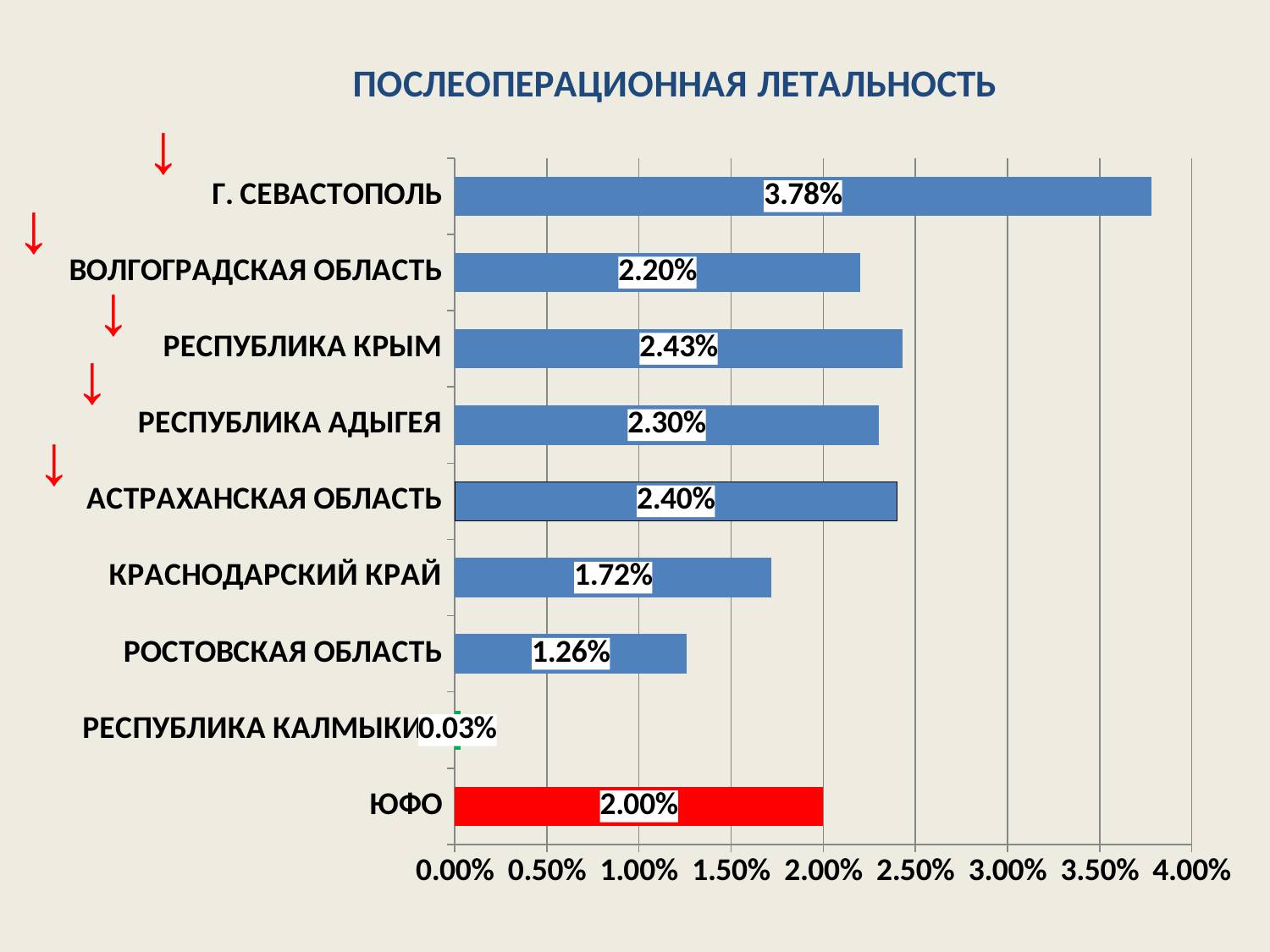
Is the value for КРАСНОДАРСКИЙ КРАЙ greater or less than 2.00%? less What is the value for Г. СЕВАСТОПОЛЬ? 3.78% Which category has the lowest value? РЕСПУБЛИКА КАЛМЫКИЯ What is the title of the chart? ПОСЛЕОПЕРАЦИОННАЯ ЛЕТАЛЬНОСТЬ What kind of chart is shown on the slide? bar chart What is the value for РОСТОВСКАЯ ОБЛАСТЬ? 1.26% What is the difference between the values for Г. СЕВАСТОПОЛЬ and ЮФО? 1.78% What is the value for ЮФО? 2.00% Which is larger, the value for РЕСПУБЛИКА КРЫМ or the value for ВОЛГОГРАДСКАЯ ОБЛАСТЬ? РЕСПУБЛИКА КРЫМ Which category has the highest value? Г. СЕВАСТОПОЛЬ How many categories are shown on the chart? 9 What is the value for РЕСПУБЛИКА КАЛМЫКИЯ? 0.03%